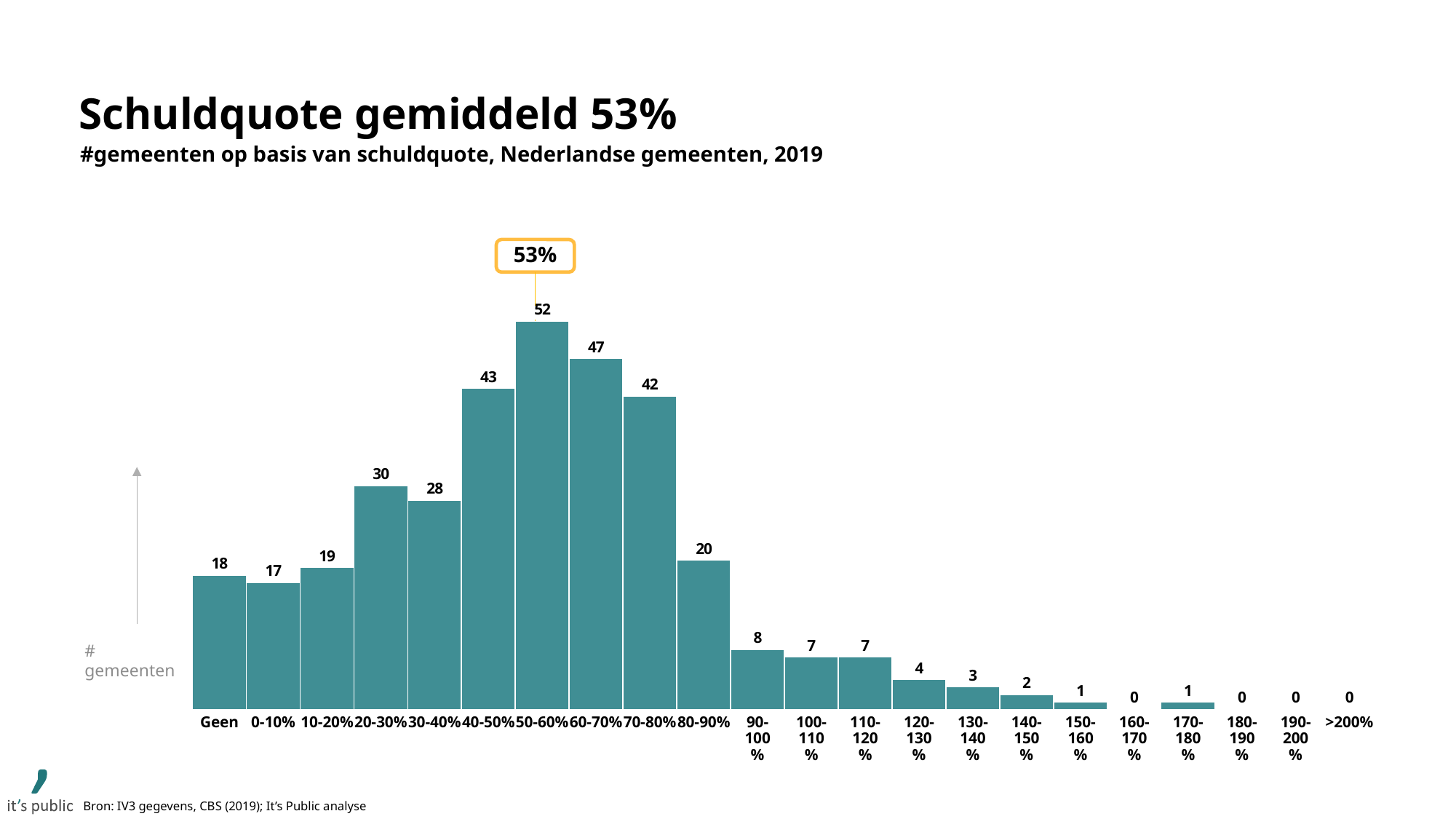
What is the value for the 170-180% category? 1 Do the values rise or fall from 80-90% to 150-160%? fall How many categories are shown on the x axis? 22 What type of chart is shown on the slide? bar chart What is the difference between the 40-50% and 30-40% categories? 15 How many municipalities fall in the 50-60% schuldquote category? 52 Which schuldquote category has the highest number of municipalities? 50-60% Which is larger, the value for 20-30% or the value for 30-40%? 20-30% What average schuldquote is highlighted in the box above the chart? 53% How many municipalities are in the 80-90% category? 20 What is the value for the 'Geen' category? 18 What is the difference between the 50-60% and 60-70% categories? 5